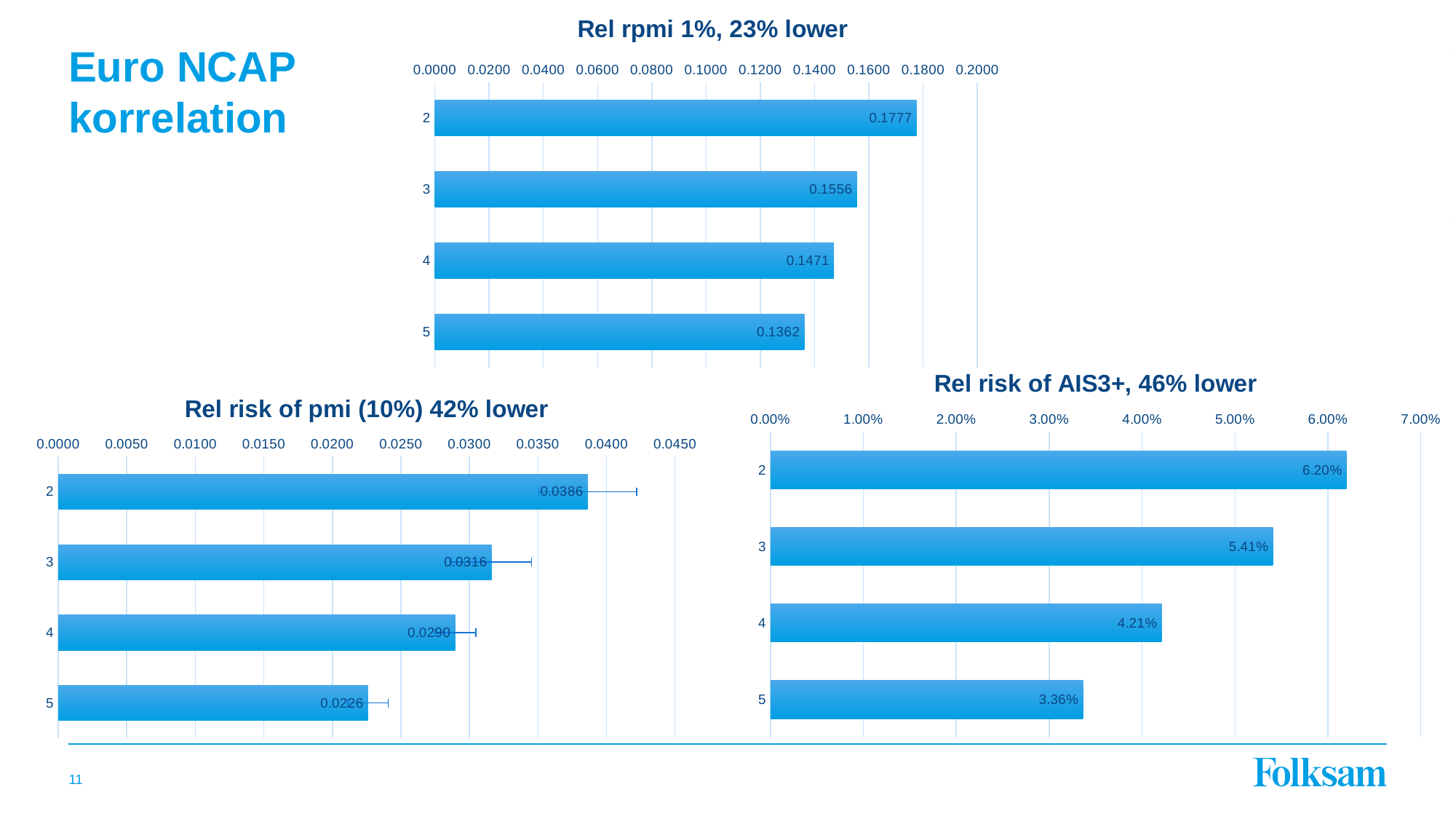
In the chart titled "Rel risk of pmi (10%) 42% lower", is the value for category 5 greater or less than 0.0250? less In the chart titled "Rel rpmi 1%, 23% lower", which category has the lowest value? 5 How many categories are shown in the chart titled "Rel risk of AIS3+, 46% lower"? 4 In the chart titled "Rel risk of pmi (10%) 42% lower", which category has the highest value? 2 In the chart titled "Rel rpmi 1%, 23% lower", what is the value for category 5? 0.1362 In the chart titled "Rel risk of AIS3+, 46% lower", which is larger, the value for category 3 or category 4? category 3 In the chart titled "Rel rpmi 1%, 23% lower", what is the value for category 2? 0.1777 In the chart titled "Rel risk of pmi (10%) 42% lower", what is the value for category 3? 0.0316 In the chart titled "Rel rpmi 1%, 23% lower", what is the difference between the values for category 2 and category 3? 0.0221 What kind of chart is the chart titled "Rel rpmi 1%, 23% lower"? bar chart In the chart titled "Rel risk of AIS3+, 46% lower", what is the value for category 4? 4.21% In the chart titled "Rel risk of AIS3+, 46% lower", what is the difference between the values for category 2 and category 5? 2.84%